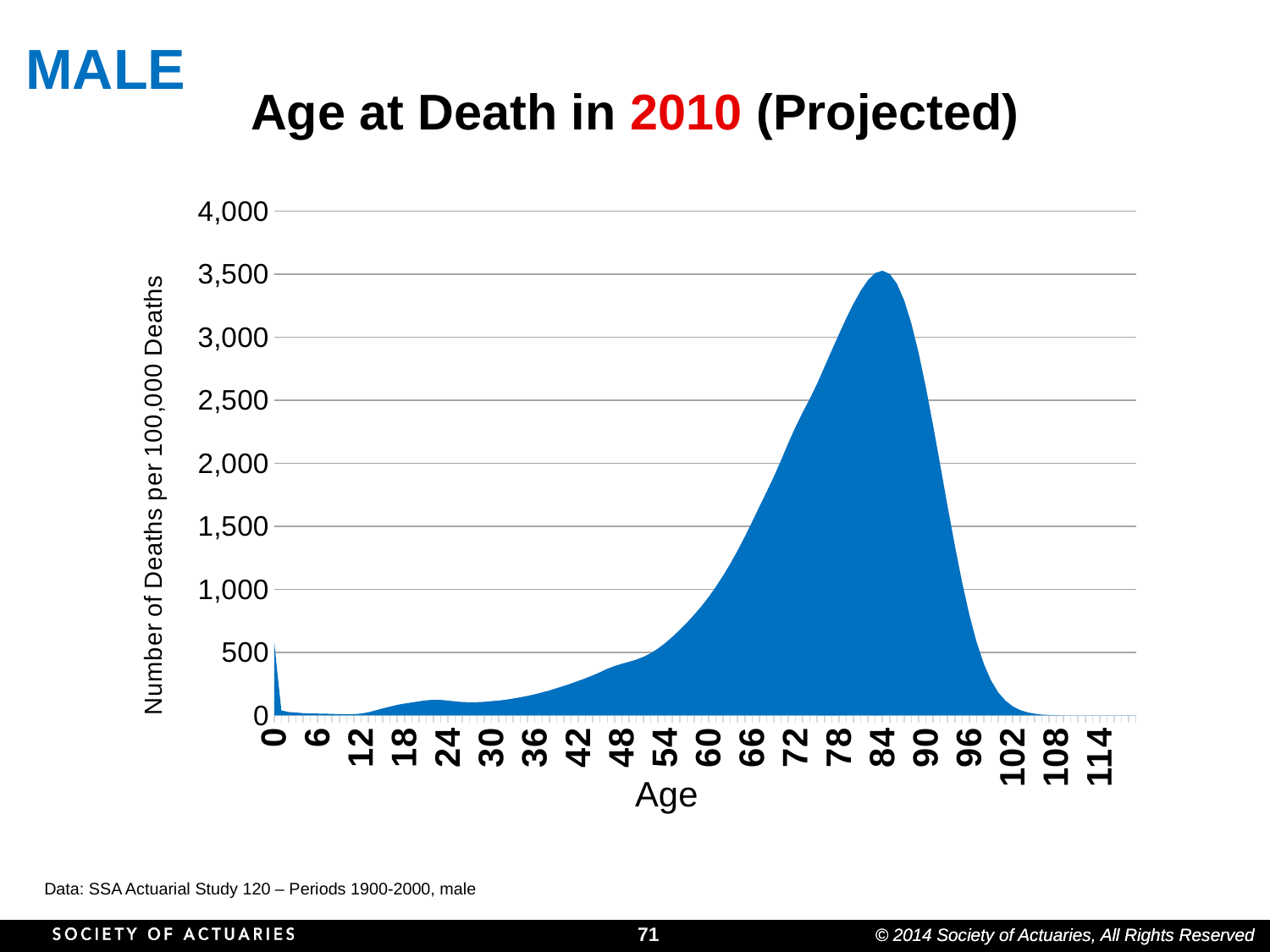
Between ages 60 and 84, do the values rise or fall? rise Is the value at age 42 greater or less than 500? less What kind of chart is shown on the slide? Area chart Between ages 84 and 108, do the values rise or fall? fall Is the value at age 72 greater or less than 1,500? greater Is the value at age 84 greater or less than 3,000? greater What is the label of the vertical axis? Number of Deaths per 100,000 Deaths At roughly which age does the number of deaths reach its peak? 84 What is the title of the chart? Age at Death in 2010 (Projected)